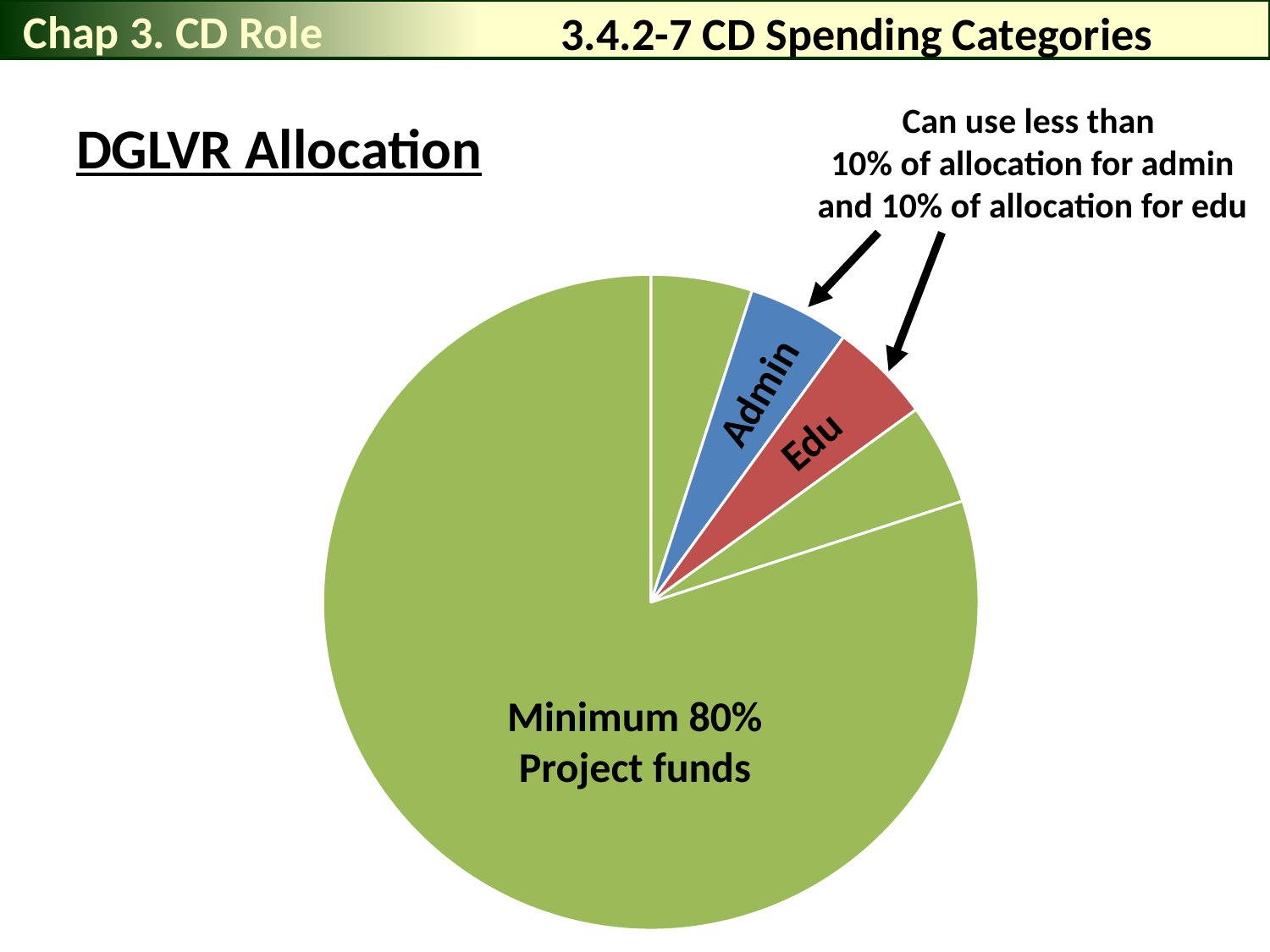
Which two slices are pointed to by the arrows from the annotation? Admin and Edu Which is larger, the Project funds slice or the Admin slice? Project funds What minimum share of the allocation is labelled for Project funds? Minimum 80% Which slice of the pie is the largest? Minimum 80% Project funds What kind of chart is shown on the slide? pie chart According to the annotation, less than what share of the allocation can be used for admin? 10% Which is larger, the Project funds slice or the Edu slice? Project funds According to the annotation, what share of the allocation can be used for edu? 10% What colour is the Admin slice? blue What is the title of the chart? DGLVR Allocation